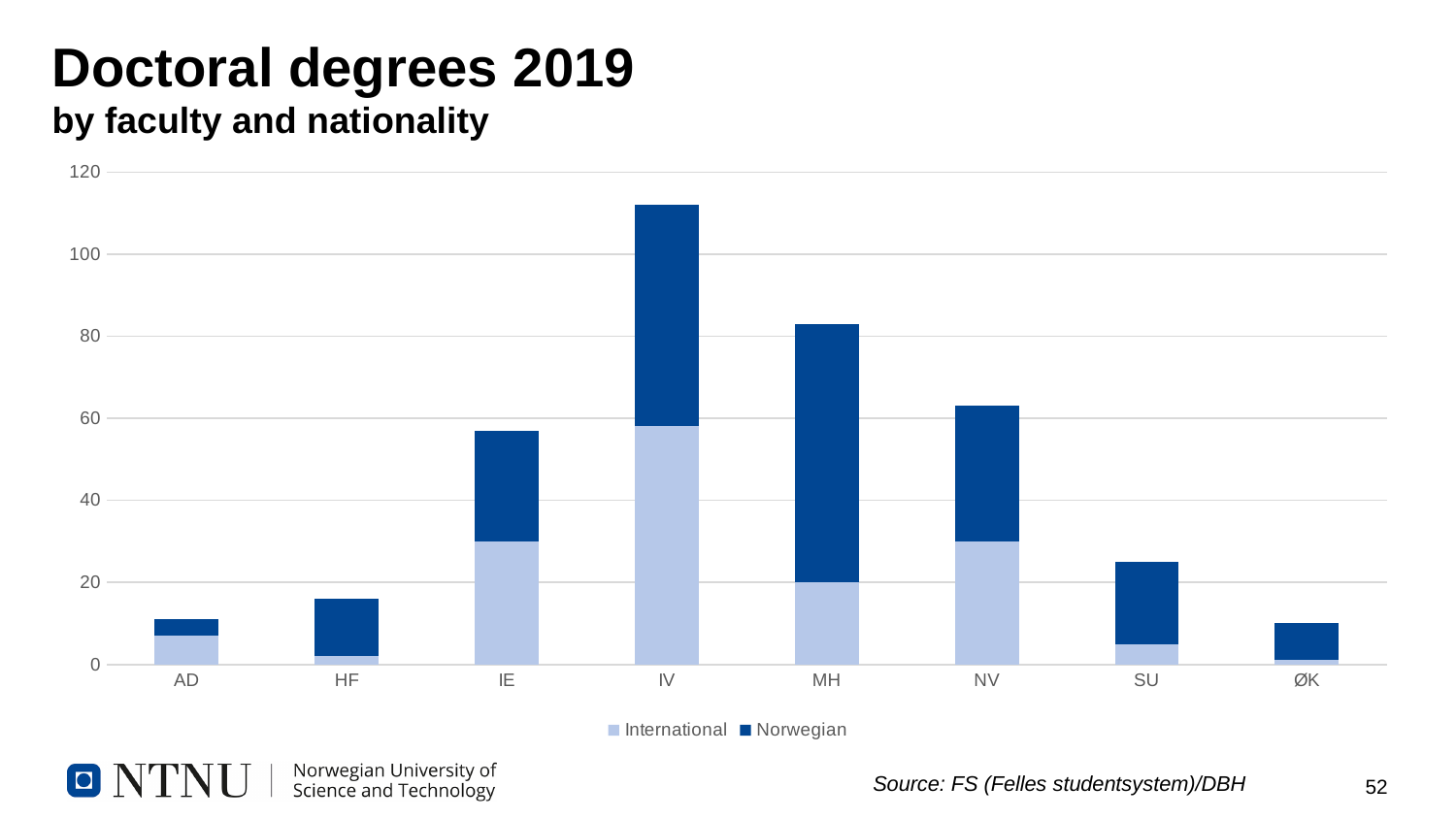
What kind of chart is shown on the slide? stacked bar chart What is the title of the chart? Doctoral degrees 2019 by faculty and nationality Is the total value for HF greater or less than 20? less How many faculties are shown on the x axis? 8 Is the total value for IV greater or less than 100? greater Which faculty has the highest total number of doctoral degrees? IV Is the total value for SU greater or less than 20? greater Which has the larger total number of doctoral degrees, MH or NV? MH Which has the larger International value, IV or MH? IV How many series does the legend list? 2